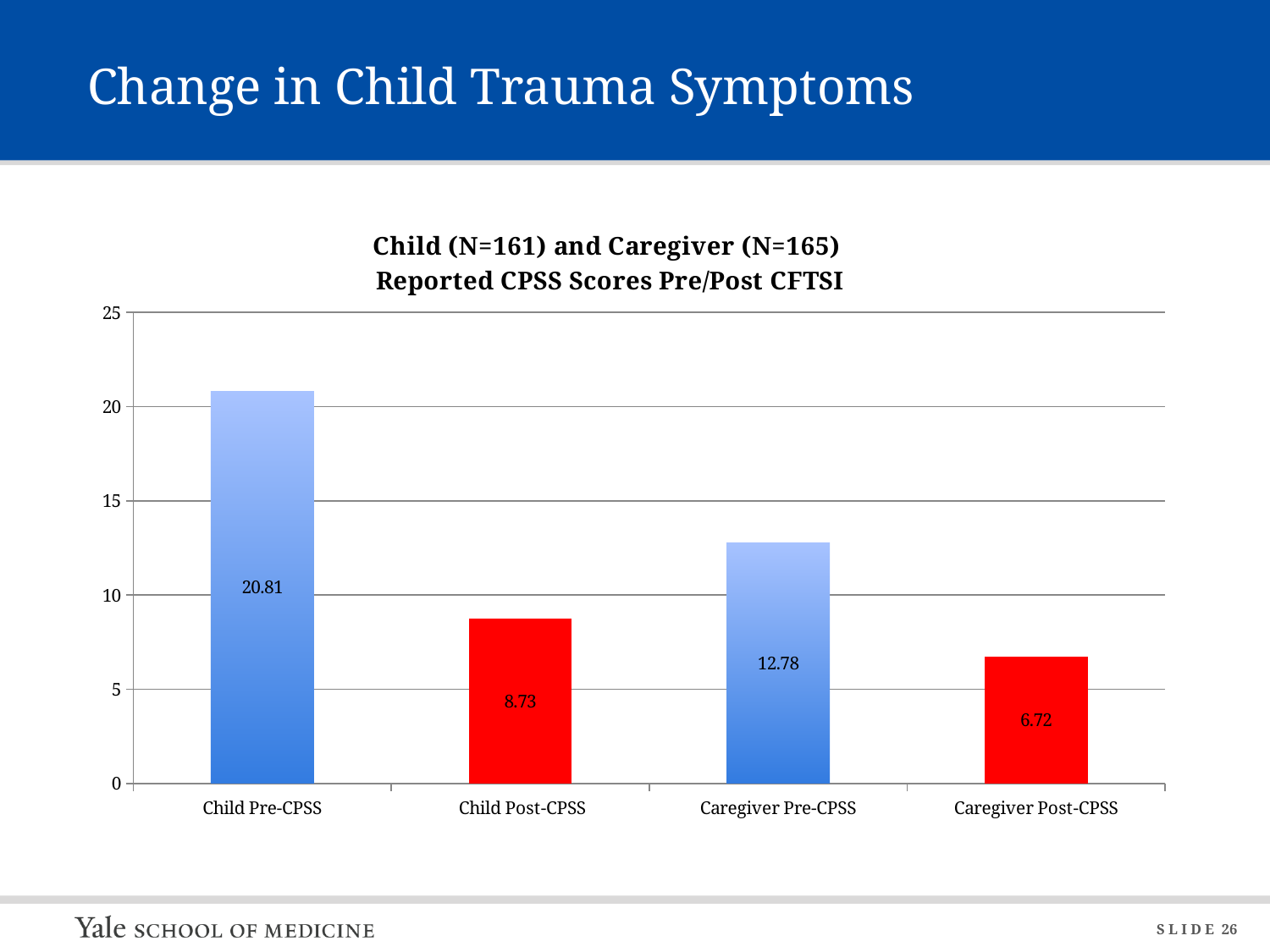
Which category has the highest value? Child Pre-CPSS Which category has the lowest value? Caregiver Post-CPSS What kind of chart is shown on the slide? bar chart What is the title of the chart? Child (N=161) and Caregiver (N=165) Reported CPSS Scores Pre/Post CFTSI Which is larger, Child Post-CPSS or Caregiver Pre-CPSS? Caregiver Pre-CPSS What is the value for Child Post-CPSS? 8.73 How many categories are shown on the x axis? 4 What is the difference between Caregiver Pre-CPSS and Caregiver Post-CPSS? 6.06 What is the difference between Child Pre-CPSS and Child Post-CPSS? 12.08 What is the value for Child Pre-CPSS? 20.81 What is the value for Caregiver Post-CPSS? 6.72 Is the value for Caregiver Pre-CPSS greater or less than 15? less